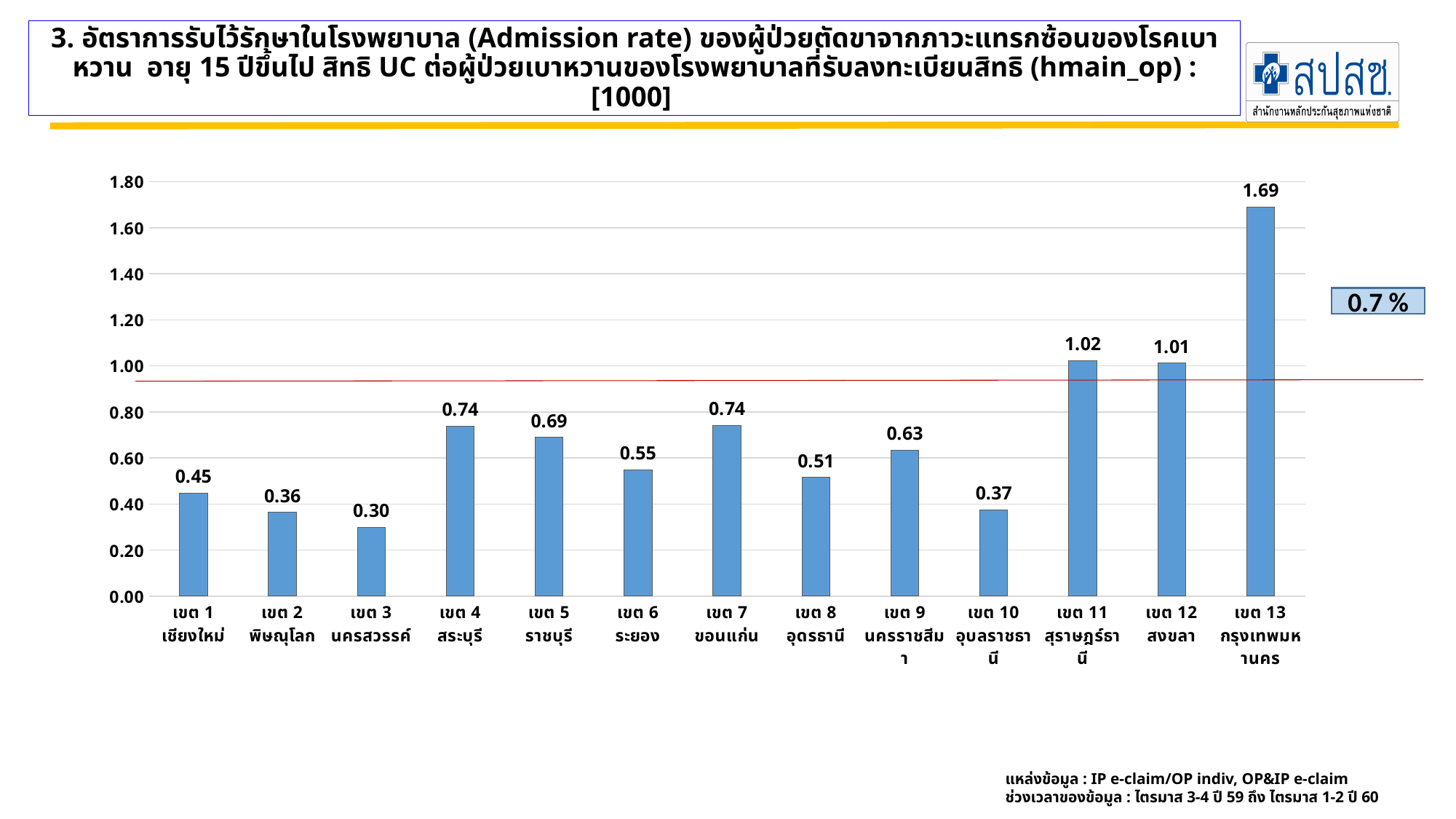
What is the value for เขต 3 นครสวรรค์? 0.30 What is the value for เขต 13 กรุงเทพมหานคร? 1.69 What percentage is shown in the box to the right of the chart? 0.7 % How many regions (เขต) are shown on the x axis? 13 What is the value for เขต 9 นครราชสีมา? 0.63 What is the difference between the values for เขต 13 กรุงเทพมหานคร and เขต 11 สุราษฎร์ธานี? 0.67 What is the difference between the values for เขต 1 เชียงใหม่ and เขต 2 พิษณุโลก? 0.09 Which region has the highest value? เขต 13 กรุงเทพมหานคร Which is larger, the value for เขต 4 สระบุรี or เขต 6 ระยอง? เขต 4 สระบุรี Is the value for เขต 12 สงขลา greater or less than 1.00? greater What kind of chart is shown on the slide? bar chart Which region has the lowest value? เขต 3 นครสวรรค์